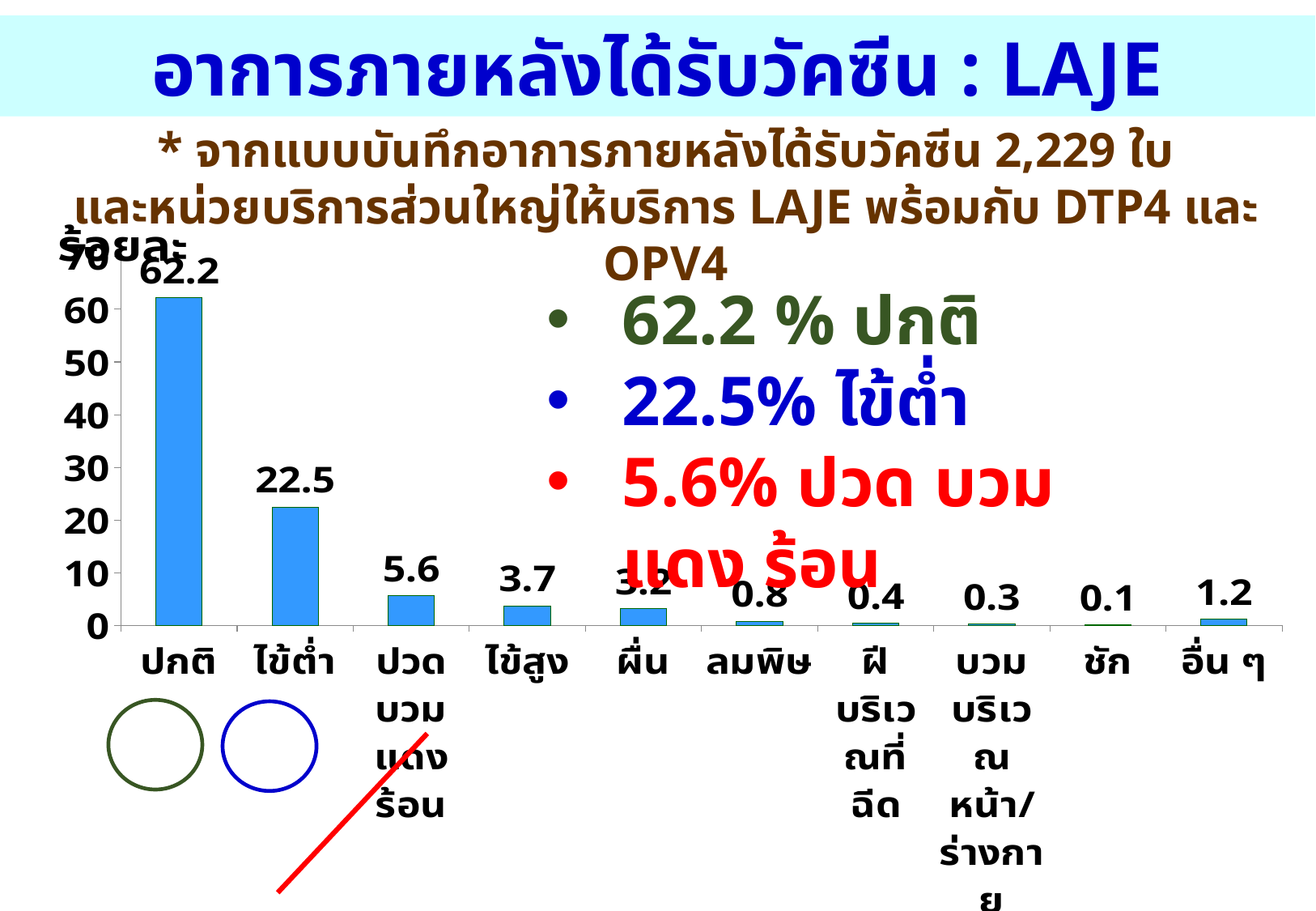
What is the value for ชัก? 0.1 Which category has the highest value? ปกติ What is the value for ปกติ? 62.2 What is the value for ไข้ต่ำ? 22.5 What is the difference between the values for ปกติ and ไข้ต่ำ? 39.7 Which category has the lowest value? ชัก What kind of chart is shown on the slide? bar chart How many categories are shown on the x axis? 10 What is the value for อื่น ๆ? 1.2 Which is larger, the value for ผื่น or the value for ลมพิษ? ผื่น What is the label on the vertical axis? ร้อยละ What is the value for ไข้สูง? 3.7